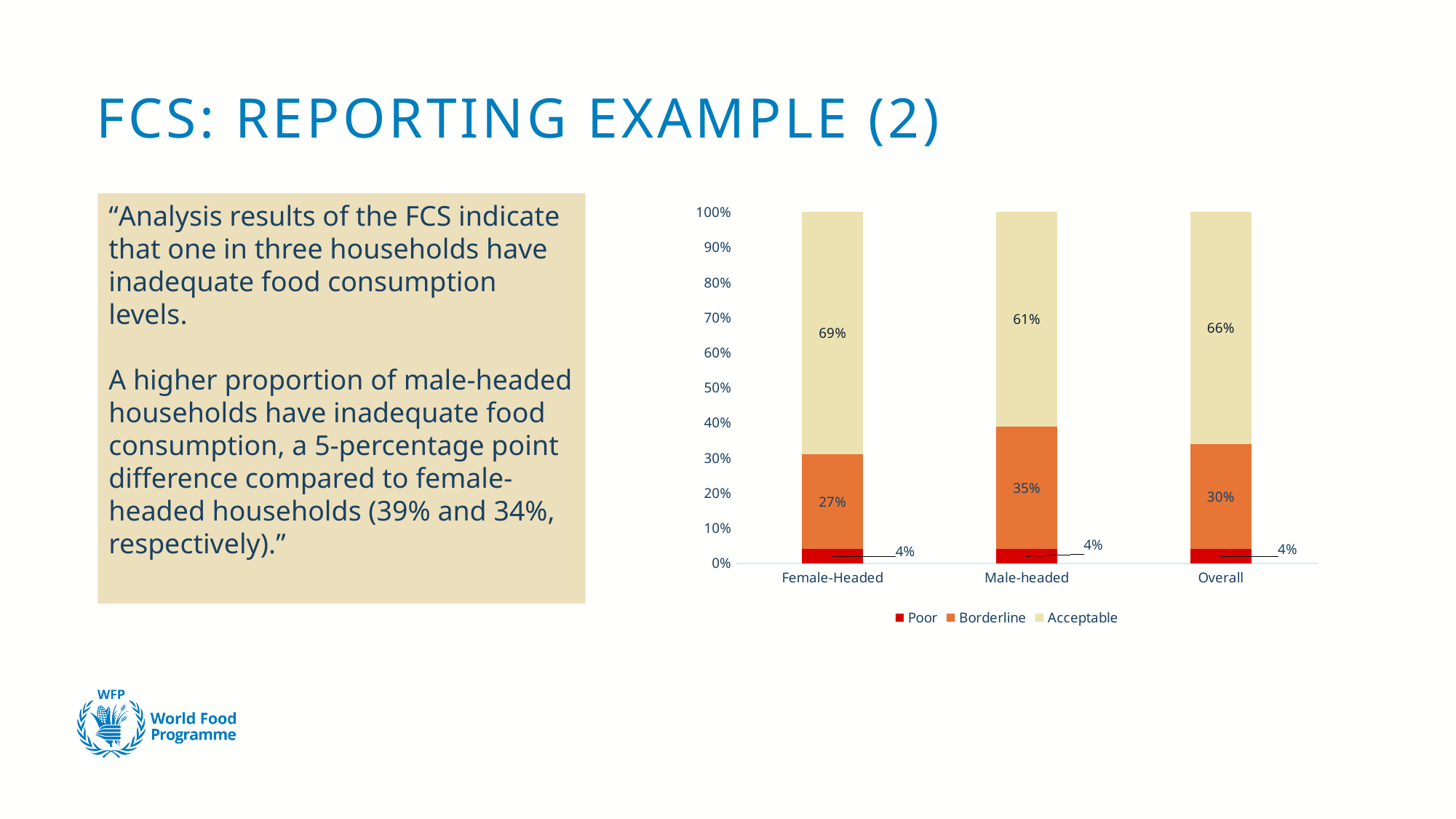
What is the difference between the Borderline values for Male-headed and Female-Headed households? 8% How many categories are shown on the x axis? 3 What is the Acceptable value for Female-Headed households? 69% What is the Poor value for Overall? 4% What kind of chart is shown on the slide? Stacked bar chart Which category has the highest Acceptable value? Female-Headed How many series does the legend list? 3 What is the Borderline value for Male-headed households? 35% Which category has the lowest Borderline value? Female-Headed What is the Acceptable value for Overall? 66% Which series is shown in red in the legend? Poor Is the Acceptable value larger for Male-headed or Overall? Overall